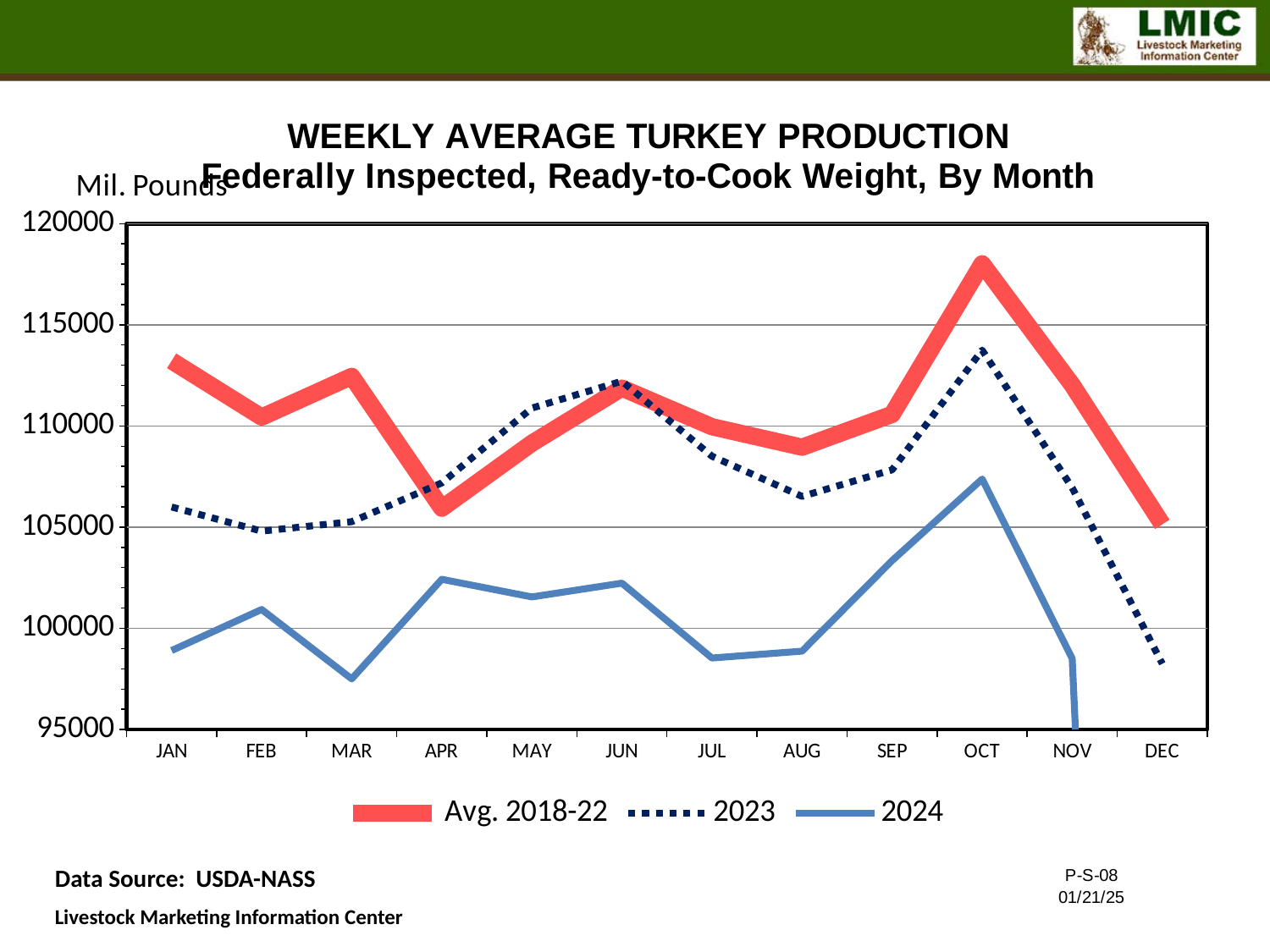
In which month does the 2023 series reach its lowest value? DEC What kind of chart is shown on the slide? Line chart In which month does the 2023 series reach its highest value? OCT Is the value for the 2024 series in OCT greater or less than 105000? greater Does the Avg. 2018-22 series rise or fall from OCT to DEC? Fall Is the value for the 2024 series in MAR greater or less than 100000? less How many months are shown along the x axis? 12 In OCT, which series is higher: Avg. 2018-22 or 2023? Avg. 2018-22 In which month does the Avg. 2018-22 series reach its highest value? OCT In which month does the 2024 series reach its highest value? OCT Is the value for the Avg. 2018-22 series in OCT greater or less than 115000? greater How many series does the legend list? 3